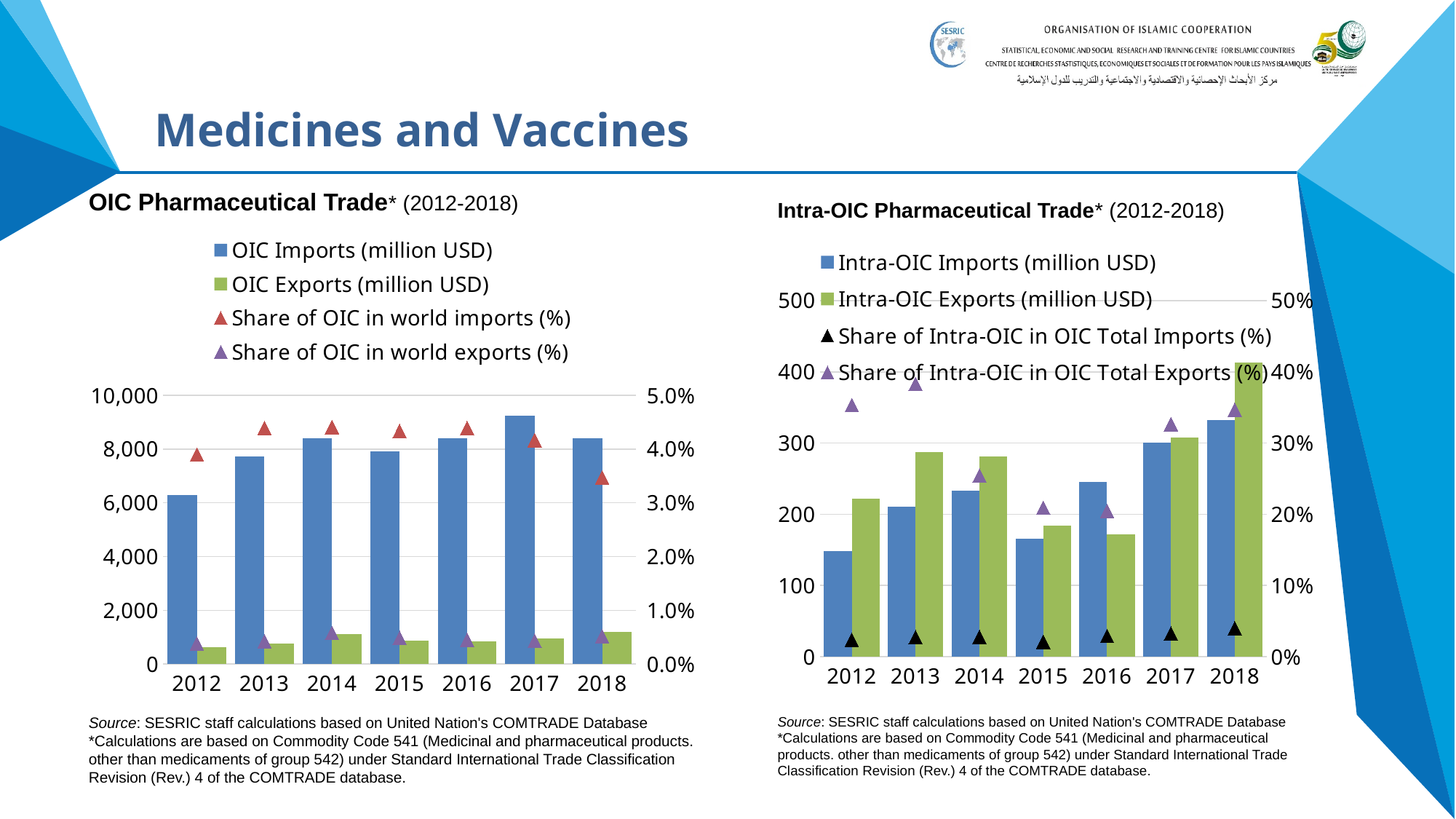
In the OIC Pharmaceutical Trade chart, which year has the lowest Share of OIC in world imports (%)? 2018 In the Intra-OIC Pharmaceutical Trade chart, is the value of Intra-OIC Imports in 2018 greater or less than 300? greater In the Intra-OIC Pharmaceutical Trade chart, which year has the highest Share of Intra-OIC in OIC Total Exports (%)? 2013 In the Intra-OIC Pharmaceutical Trade chart, is the value of Intra-OIC Imports in 2012 greater or less than 200? less In the OIC Pharmaceutical Trade chart, which year has the lowest OIC Imports? 2012 In the Intra-OIC Pharmaceutical Trade chart, which is larger in 2012: Intra-OIC Imports or Intra-OIC Exports? Intra-OIC Exports In the OIC Pharmaceutical Trade chart, which year has the highest OIC Imports? 2017 In the OIC Pharmaceutical Trade chart, is the value of OIC Imports in 2017 greater or less than 8,000? greater In the Intra-OIC Pharmaceutical Trade chart, which year has the highest Intra-OIC Exports? 2018 How many series does the legend of the OIC Pharmaceutical Trade chart list? 4 How many years are shown on the x axis of the Intra-OIC Pharmaceutical Trade chart? 7